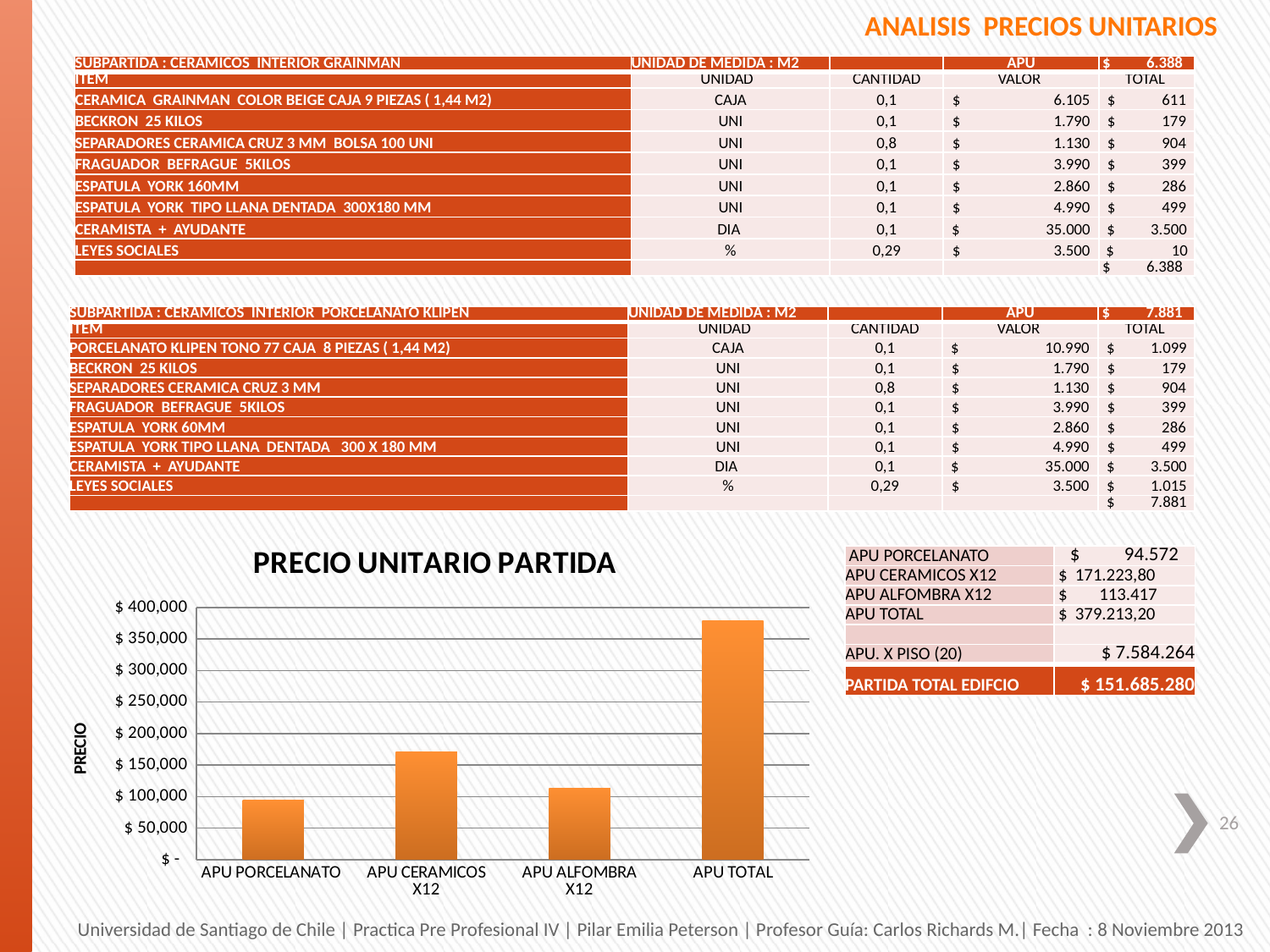
How many categories are plotted in the PRECIO UNITARIO PARTIDA chart? 4 Which category has the lowest bar in the PRECIO UNITARIO PARTIDA chart? APU PORCELANATO In the PRECIO UNITARIO PARTIDA chart, which is larger: APU PORCELANATO or APU ALFOMBRA X12? APU ALFOMBRA X12 In the PRECIO UNITARIO PARTIDA chart, is the value for APU ALFOMBRA X12 greater or less than $ 100,000? greater In the PRECIO UNITARIO PARTIDA chart, is the value for APU TOTAL greater or less than $ 350,000? greater Which category has the highest bar in the PRECIO UNITARIO PARTIDA chart? APU TOTAL In the PRECIO UNITARIO PARTIDA chart, is the value for APU PORCELANATO greater or less than $ 100,000? less What is the highest tick value shown on the vertical axis of the PRECIO UNITARIO PARTIDA chart? $ 400,000 What is the label on the vertical axis of the PRECIO UNITARIO PARTIDA chart? PRECIO In the PRECIO UNITARIO PARTIDA chart, which is larger: APU CERAMICOS X12 or APU ALFOMBRA X12? APU CERAMICOS X12 What kind of chart is shown under the title PRECIO UNITARIO PARTIDA? bar chart